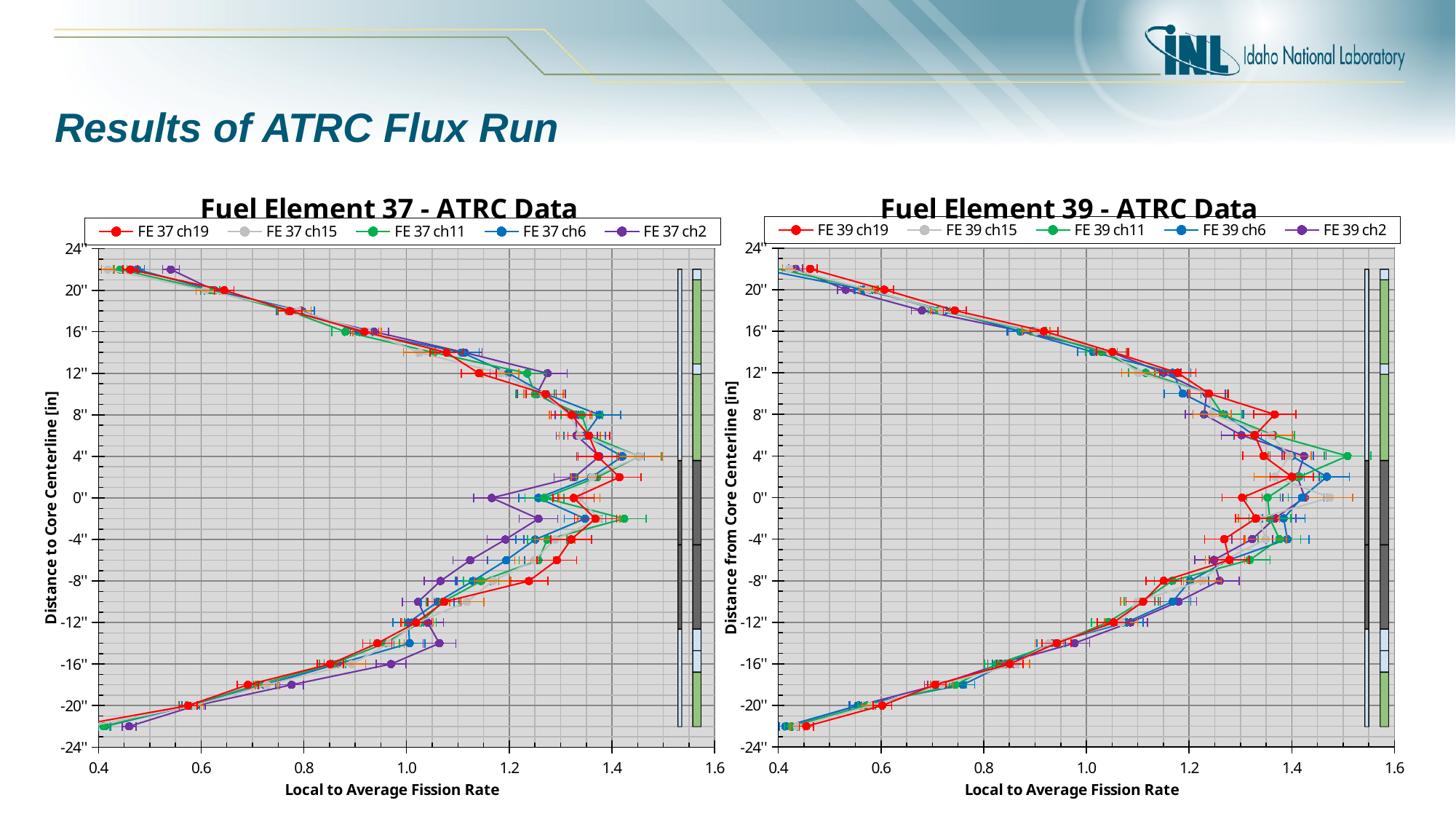
What is the x-axis title of the "Fuel Element 37 - ATRC Data" chart? Local to Average Fission Rate How many series does the legend of the "Fuel Element 37 - ATRC Data" chart list? 5 In the "Fuel Element 37 - ATRC Data" chart, is the value for FE 37 ch19 at 22" greater or less than 0.6? less In the "Fuel Element 39 - ATRC Data" chart, do the values for FE 39 ch19 rise or fall as the distance goes from 22" down to 8"? rise In the "Fuel Element 39 - ATRC Data" chart, is the value for FE 39 ch19 at -22" greater or less than 0.6? less In the "Fuel Element 37 - ATRC Data" chart, is the value for FE 37 ch2 at -20" greater or less than 0.8? less In the "Fuel Element 39 - ATRC Data" chart, how many data points does the FE 39 ch19 series have? 23 What type of chart is the "Fuel Element 37 - ATRC Data" chart? Line chart How many series does the legend of the "Fuel Element 39 - ATRC Data" chart list? 5